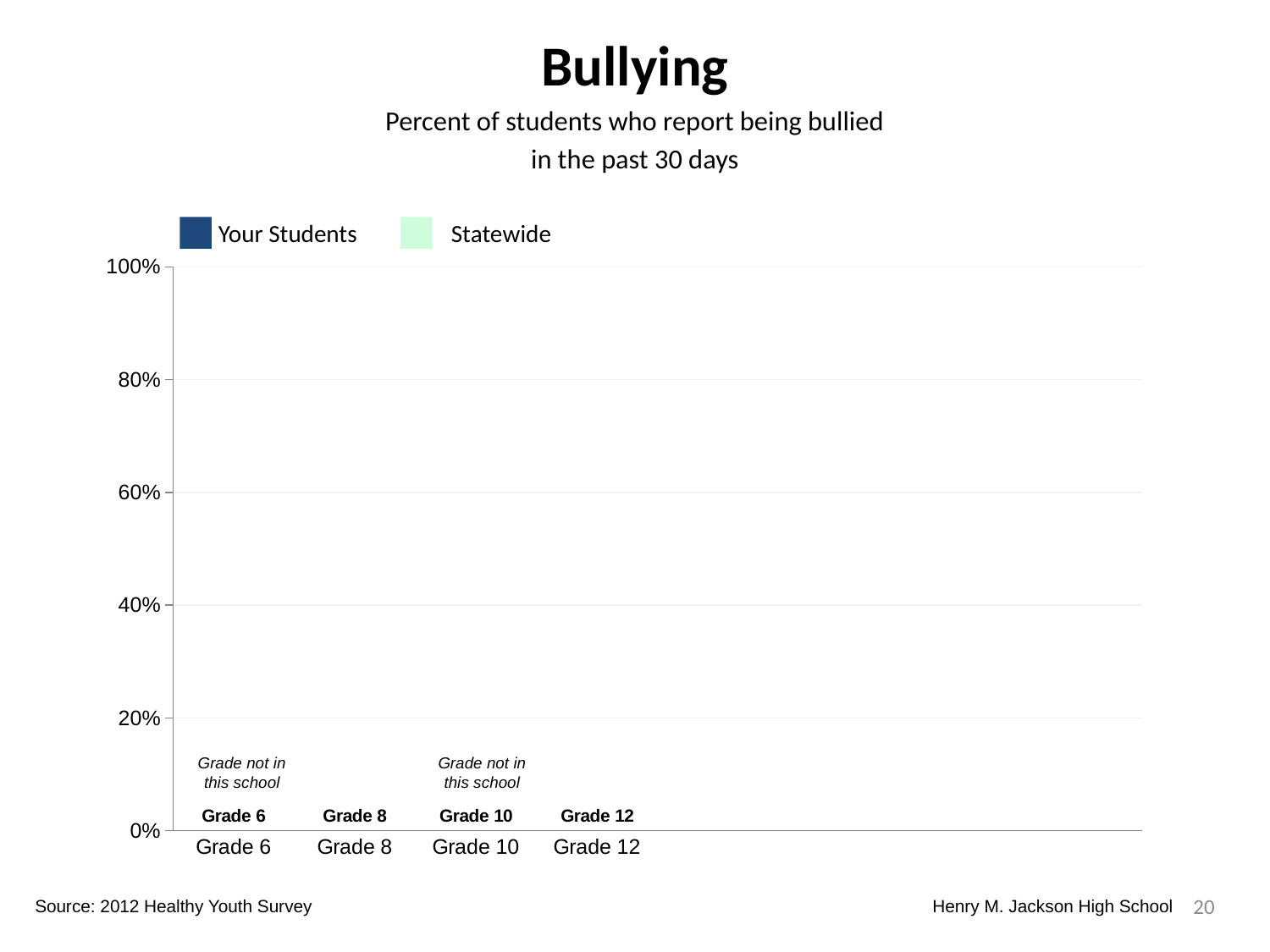
Which grade categories are marked as 'Grade not in this school' on the Bullying chart? Grade 6 and Grade 10 How many grade categories are shown on the x axis of the Bullying chart? 4 What is the title of the chart on the slide? Bullying How many series does the legend of the Bullying chart list? 2 What is the highest value shown on the y axis of the Bullying chart? 100% What are the two series named in the legend of the Bullying chart? Your Students and Statewide